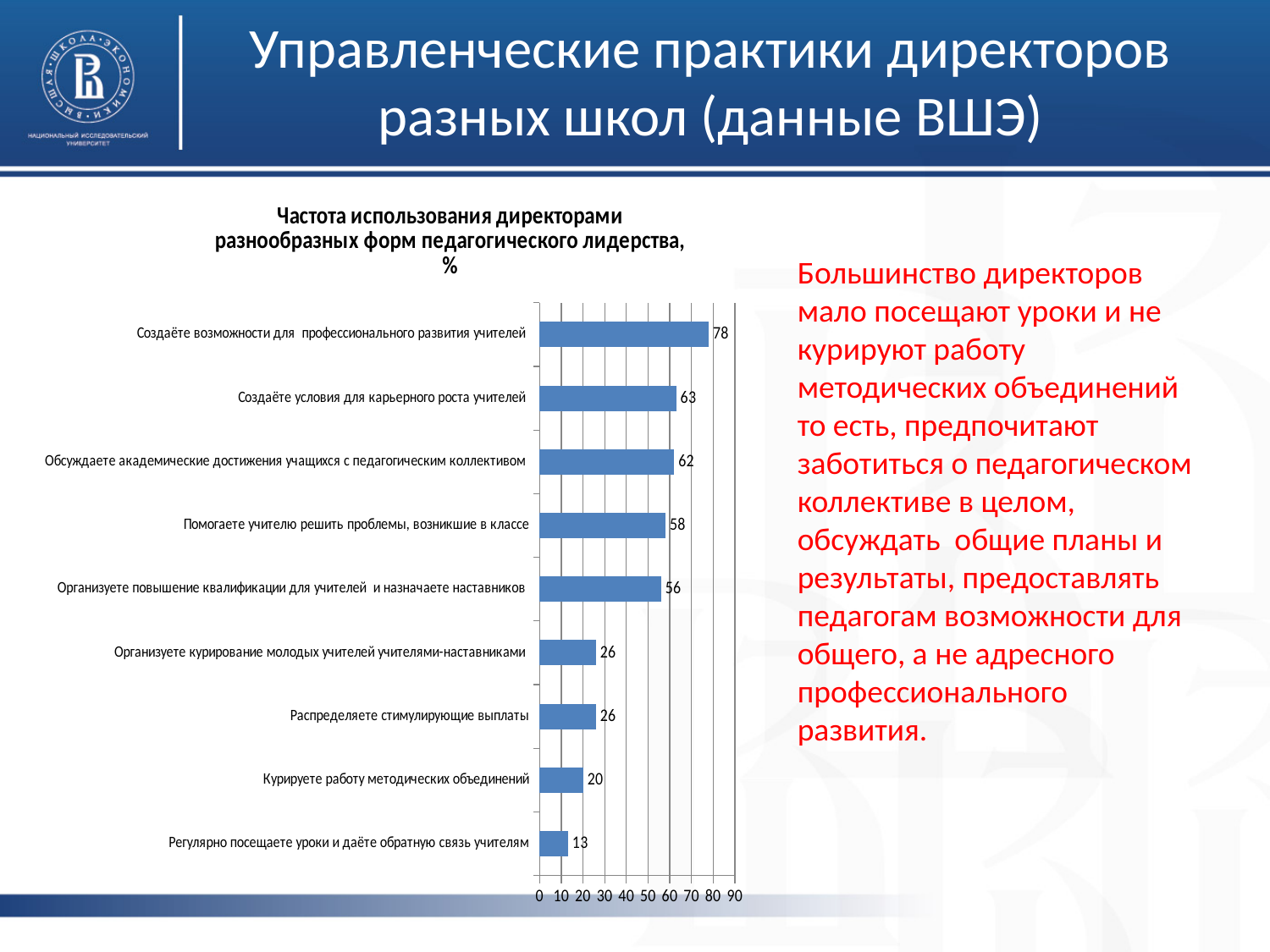
What is the difference between the values for "Создаёте возможности для профессионального развития учителей" and "Регулярно посещаете уроки и даёте обратную связь учителям"? 65 Which category has the lowest value? Регулярно посещаете уроки и даёте обратную связь учителям What is the title of the chart? Частота использования директорами разнообразных форм педагогического лидерства, % Which category has the highest value? Создаёте возможности для профессионального развития учителей What is the value for "Курируете работу методических объединений"? 20 What is the value for "Помогаете учителю решить проблемы, возникшие в классе"? 58 Which is larger: the value for "Создаёте условия для карьерного роста учителей" or for "Организуете повышение квалификации для учителей и назначаете наставников"? Создаёте условия для карьерного роста учителей What is the value for "Создаёте возможности для профессионального развития учителей"? 78 Is the value for "Организуете курирование молодых учителей учителями-наставниками" greater or less than 50? less What is the difference between the values for "Обсуждаете академические достижения учащихся с педагогическим коллективом" and "Распределяете стимулирующие выплаты"? 36 How many categories are shown in the chart? 9 What kind of chart is shown on the slide? bar chart